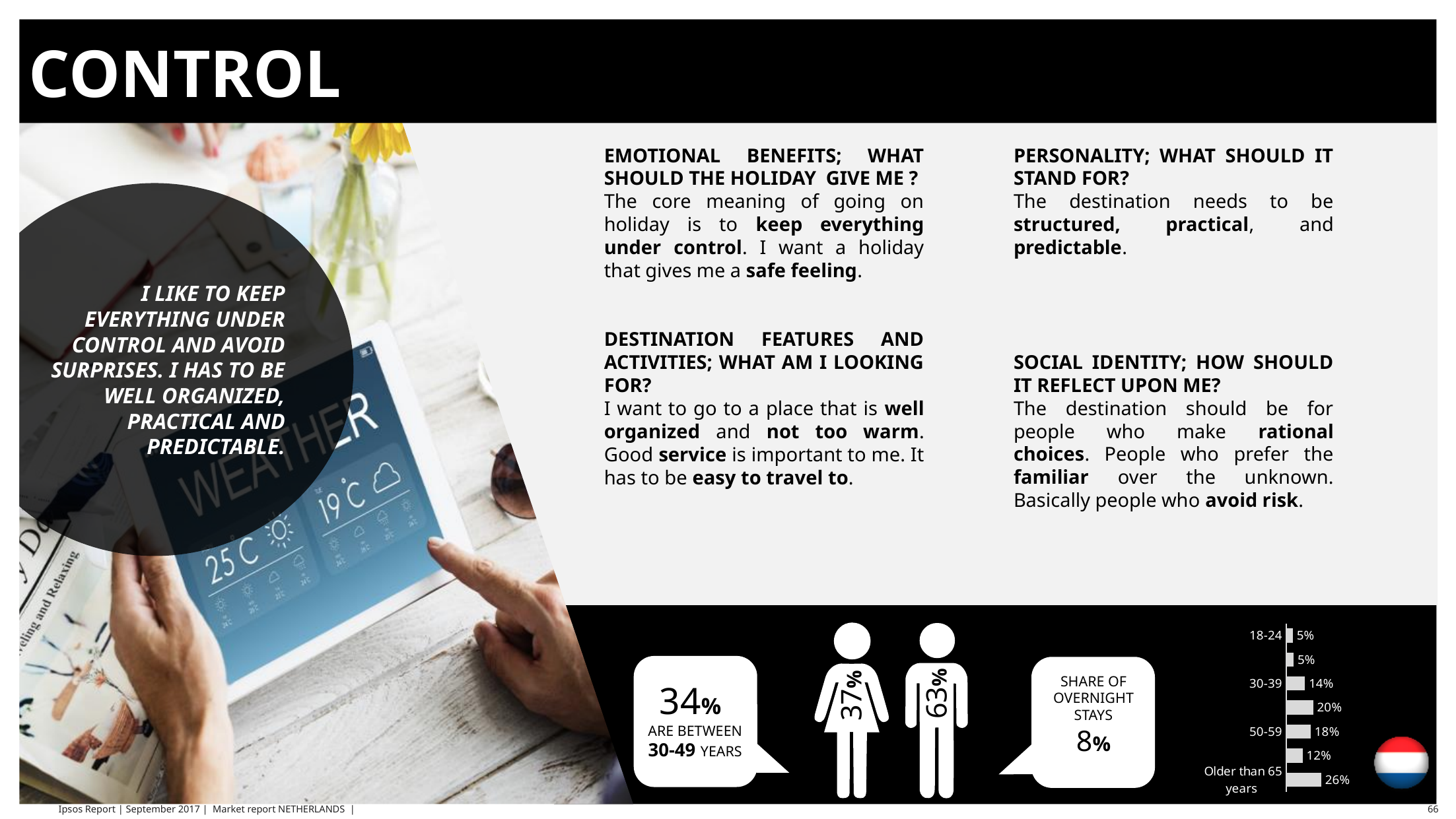
How many bars are plotted in the age-group bar chart at the bottom right? 7 In the age-group bar chart at the bottom right, which is larger: the value for 18-24 or the value for 'Older than 65 years'? Older than 65 years In the age-group bar chart at the bottom right, what is the value for the 50-59 group? 18% What kind of chart is the age-group chart at the bottom right of the slide? Bar chart In the age-group bar chart at the bottom right, which labelled age group has the highest value? Older than 65 years In the age-group bar chart at the bottom right, which is larger: the value for 50-59 or the value for 30-39? 50-59 In the age-group bar chart at the bottom right, what is the difference between the 30-39 value and the 18-24 value? 9 percentage points In the age-group bar chart at the bottom right, what is the value for the 'Older than 65 years' group? 26% In the age-group bar chart at the bottom right, what is the largest data label shown on any bar? 26% In the age-group bar chart at the bottom right, what is the value for the 30-39 group? 14% In the age-group bar chart at the bottom right, what is the difference between the 'Older than 65 years' value and the 50-59 value? 8 percentage points In the age-group bar chart at the bottom right, what is the value for the 18-24 group? 5%